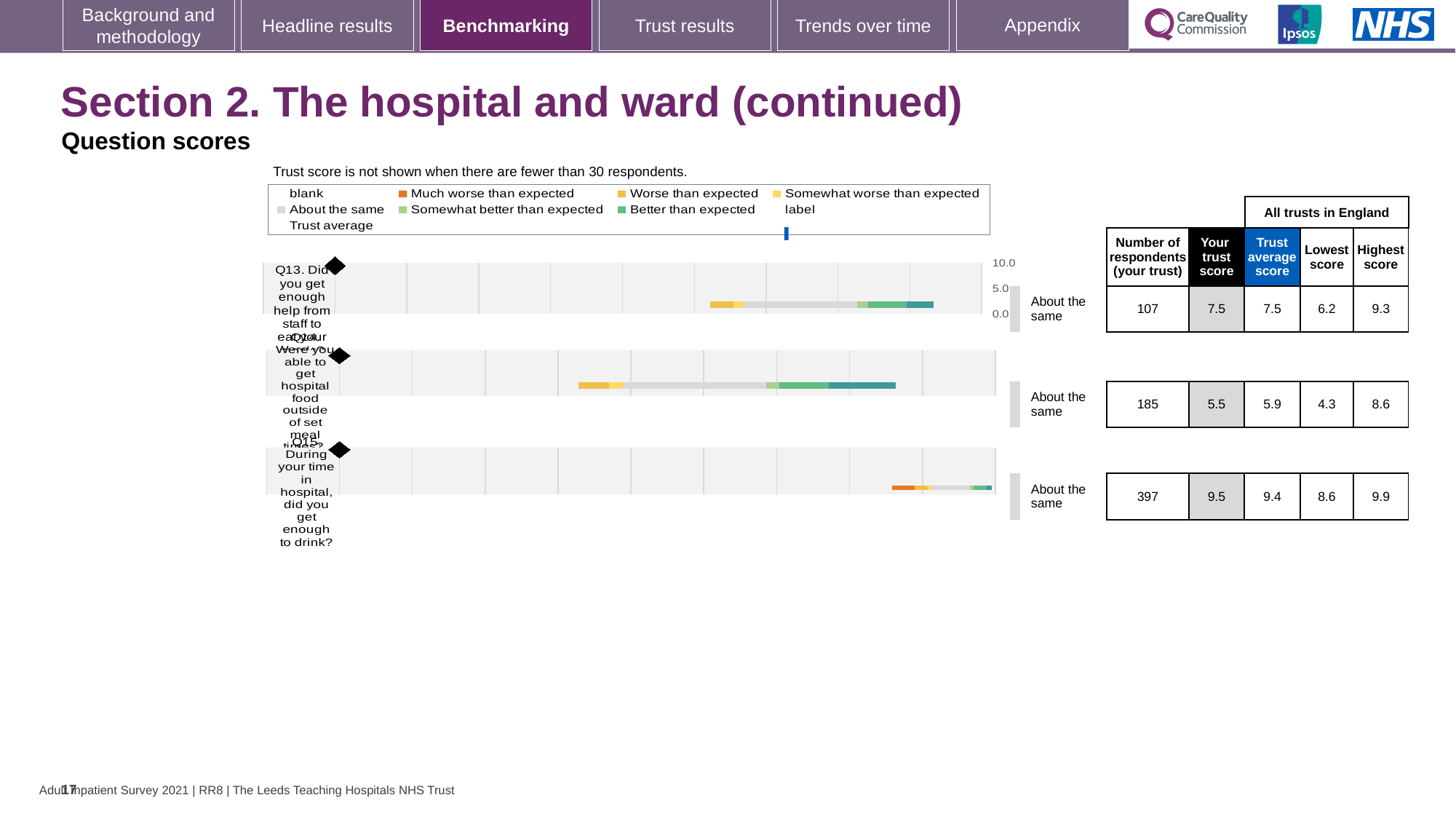
Which question has the highest 'Your trust score'? Q15 What is the 'Your trust score' for Q13 (Did you get enough help from staff to eat your meals?)? 7.5 What is the trust average score for Q15 (did you get enough to drink?)? 9.4 What kind of chart is used to show the question scores on this slide? Bar chart For Q15, what is the difference between the highest score and the lowest score across all trusts in England? 1.3 For Q14, which is larger: the 'Your trust score' or the trust average score? Trust average score Which question has the lowest 'Your trust score'? Q14 How many respondents are shown for Q14 (Were you able to get hospital food outside of set meal times?)? 185 How many questions (Q13, Q14, Q15) have a chart on this slide? 3 For Q14, how much higher is the trust average score than the 'Your trust score'? 0.4 What is the lowest score across all trusts in England for Q14? 4.3 What benchmark category label is shown next to each of the three charts? About the same